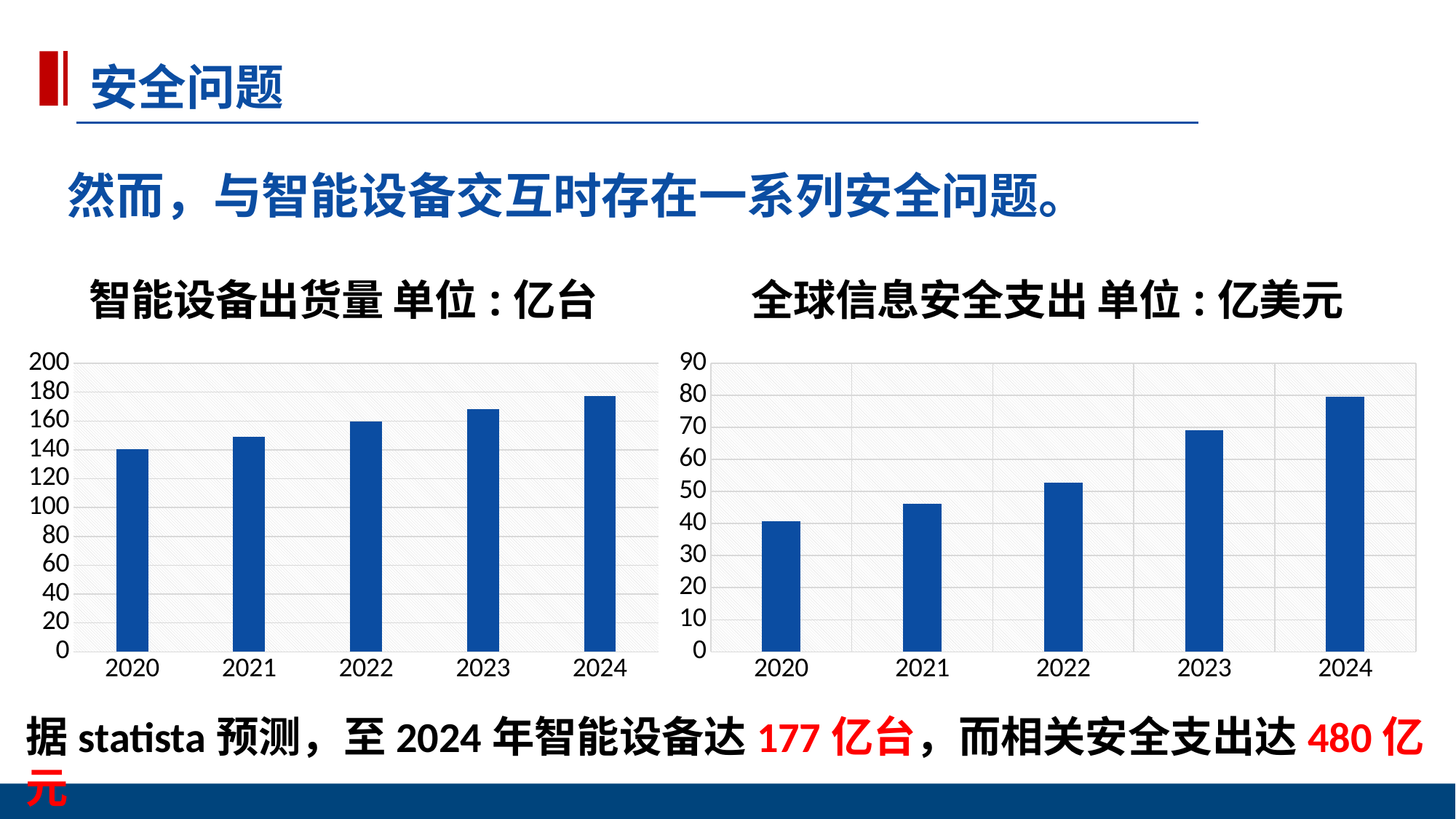
In the left chart (智能设备出货量), which year has the lowest value? 2020 In the left chart (智能设备出货量), is the value for 2020 greater or less than 160? less In the right chart (全球信息安全支出), which year has the highest value? 2024 In the right chart (全球信息安全支出), which year has the lowest value? 2020 In the left chart (智能设备出货量), do the values rise or fall from 2020 to 2024? rise In the right chart (全球信息安全支出), is the value for 2023 greater or less than 60? greater What unit is stated in the title of the right chart? 亿美元 In the right chart (全球信息安全支出), which is larger, the value for 2022 or the value for 2023? 2023 In the left chart (智能设备出货量), which year has the highest value? 2024 In the left chart (智能设备出货量), is the value for 2022 greater or less than 140? greater In the left chart (智能设备出货量), how many years are shown on the x axis? 5 What kind of chart is the left chart titled 智能设备出货量 单位：亿台? bar chart